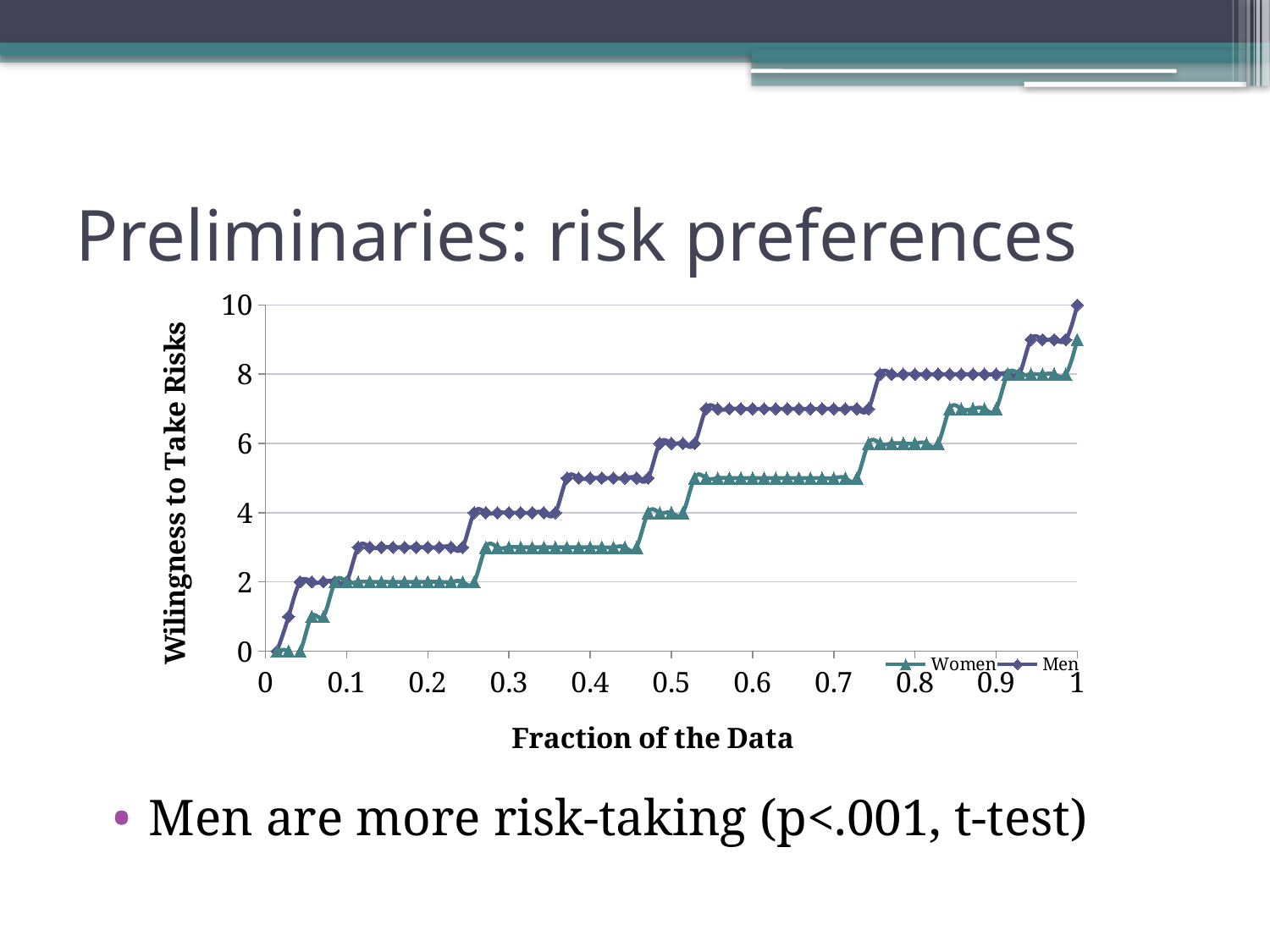
Which two series are listed in the legend? Women and Men Do the values for Men rise or fall as the fraction of the data increases from 0 to 1? Rise What is the highest value reached by the Men series? 10 What is the title of the y axis? Wilingness to Take Risks At a fraction of the data of 0.6, which series has the larger value, Men or Women? Men What kind of chart is shown on the slide? Line chart How many series does the legend list? 2 What is the Willingness to Take Risks value for Men at a fraction of the data of 1? 10